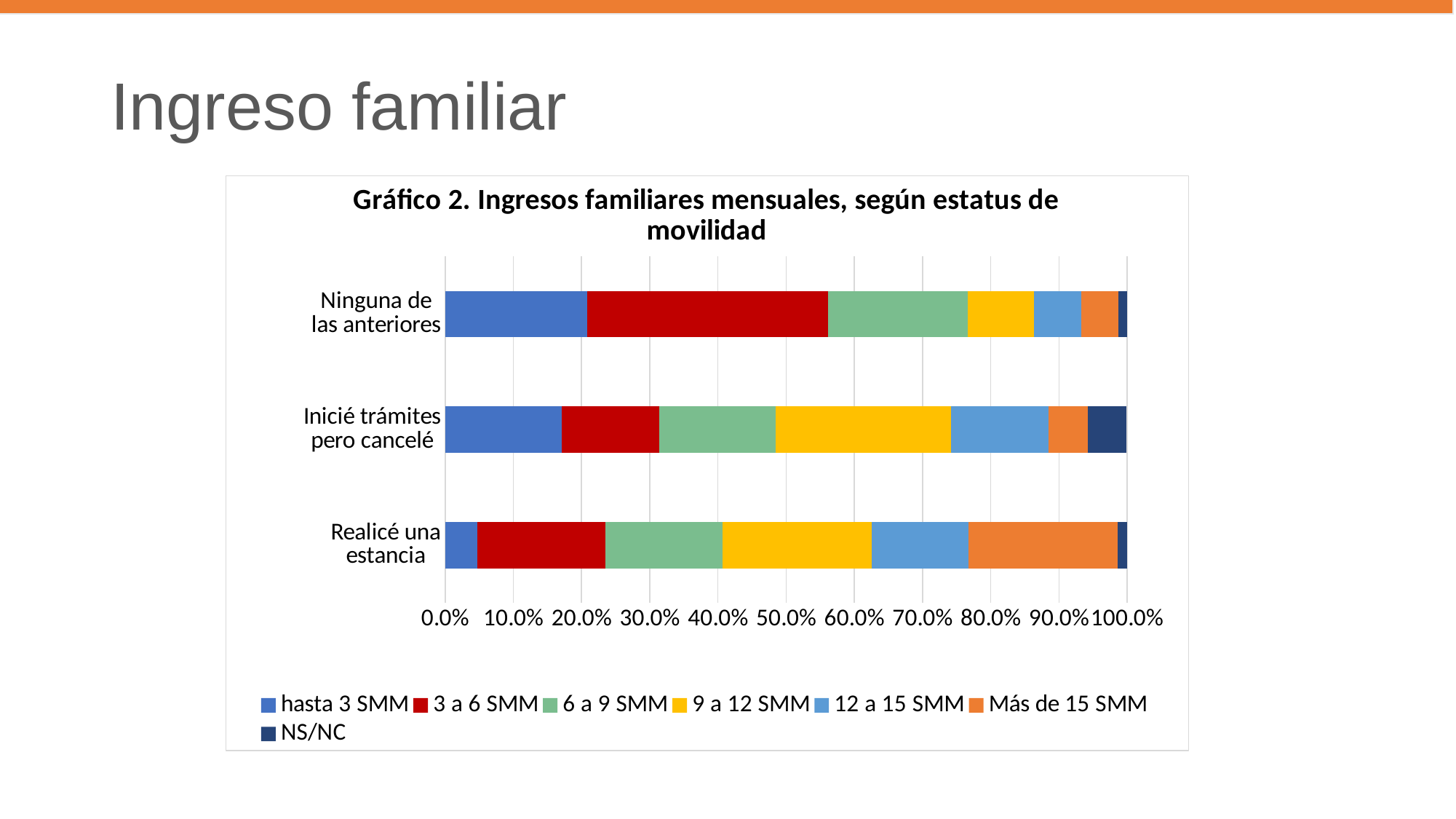
What is the title of the chart? Gráfico 2. Ingresos familiares mensuales, según estatus de movilidad Is the 'hasta 3 SMM' share for 'Ninguna de las anteriores' greater or less than 10%? greater Which legend entry is shown in red? 3 a 6 SMM What kind of chart is shown on the slide? Stacked bar chart Which category has the larger 'Más de 15 SMM' share: 'Realicé una estancia' or 'Ninguna de las anteriores'? Realicé una estancia Which income series takes the largest share of the bar for 'Inicié trámites pero cancelé'? 9 a 12 SMM At what value does each stacked bar end on the x axis? 100.0% Which income series takes the largest share of the bar for 'Ninguna de las anteriores'? 3 a 6 SMM Is the 'hasta 3 SMM' share for 'Realicé una estancia' greater or less than 10%? less How many mobility status categories are plotted on the chart? 3 Which category has the larger 'hasta 3 SMM' share: 'Ninguna de las anteriores' or 'Realicé una estancia'? Ninguna de las anteriores How many series does the legend list? 7